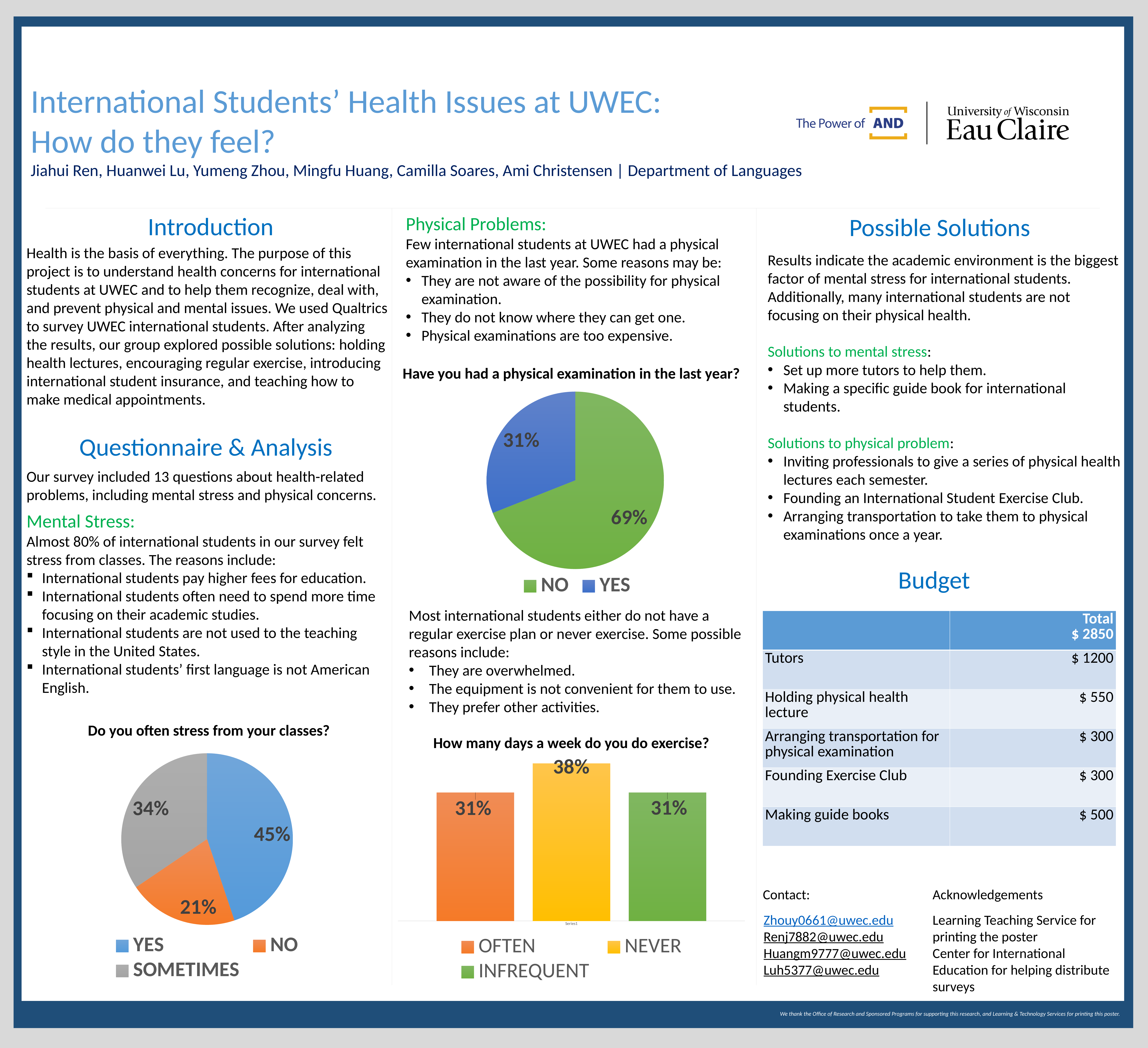
In the chart 'How many days a week do you do exercise?', what is the difference between NEVER and OFTEN? 7% In the chart 'Do you often stress from your classes?', what share of respondents answered YES? 45% In the chart 'Have you had a physical examination in the last year?', what is the difference between the NO and YES shares? 38% What kind of chart is 'Have you had a physical examination in the last year?'? pie chart In the chart 'How many days a week do you do exercise?', which category has the highest value? NEVER In the chart 'Do you often stress from your classes?', what share of respondents answered SOMETIMES? 34% In the chart 'Have you had a physical examination in the last year?', what share of respondents answered NO? 69% In the chart 'How many days a week do you do exercise?', what colour is the NEVER bar? yellow In the chart 'How many days a week do you do exercise?', what is the value for NEVER? 38% What kind of chart is 'How many days a week do you do exercise?'? bar chart In the chart 'Do you often stress from your classes?', which response has the smallest share? NO In the chart 'Do you often stress from your classes?', how many categories does the legend list? 3